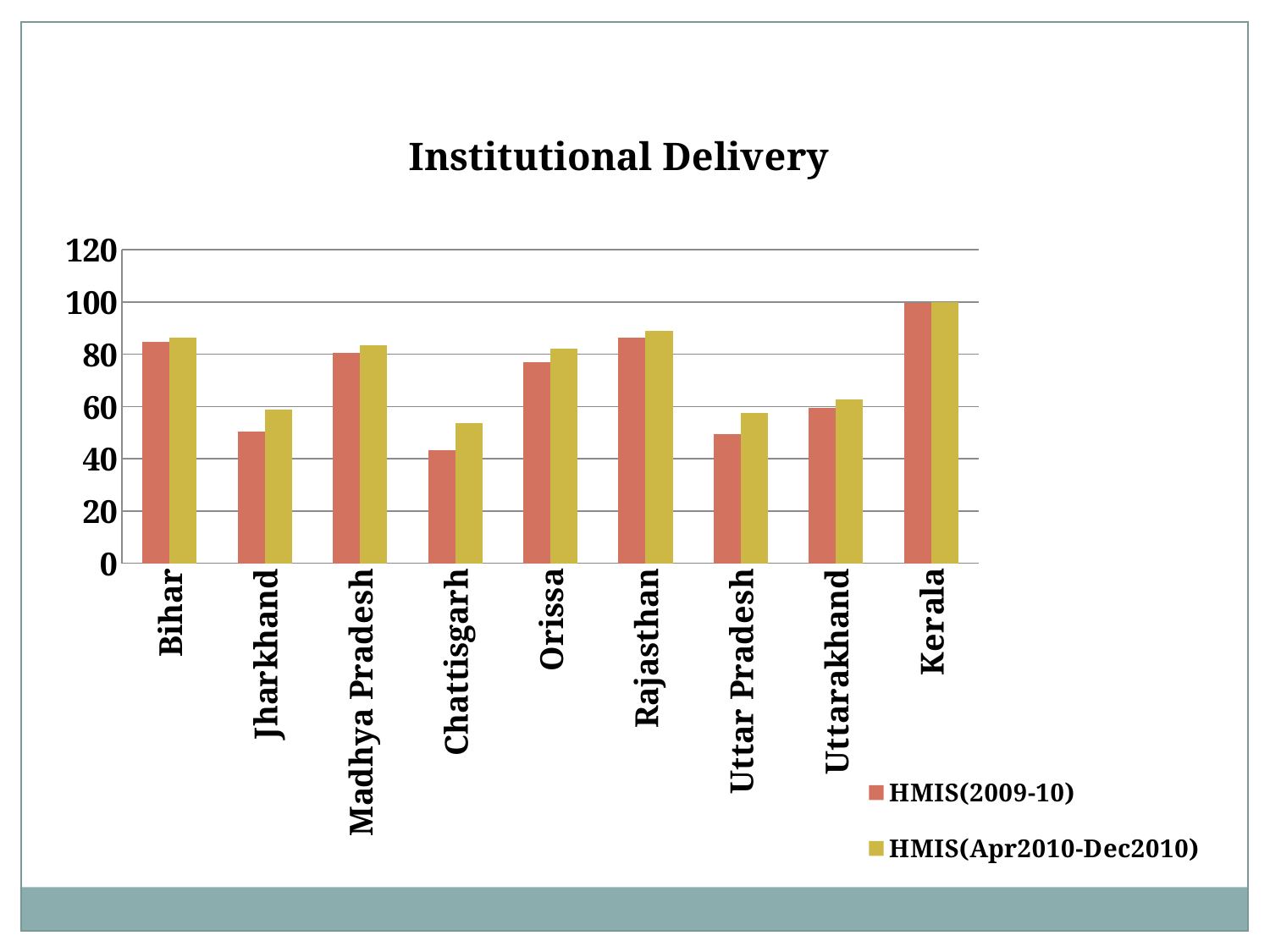
What is the title of the chart? Institutional Delivery How many series does the legend list? 2 Is the HMIS(Apr2010-Dec2010) value for Uttar Pradesh greater or less than 40? greater How many states are shown on the x axis? 9 Which state has the lowest value for HMIS(2009-10)? Chattisgarh Is the HMIS(2009-10) value for Bihar greater or less than 80? greater Which state has the highest value for HMIS(2009-10)? Kerala For Jharkhand, which series has the larger value, HMIS(2009-10) or HMIS(Apr2010-Dec2010)? HMIS(Apr2010-Dec2010) Which state has the lowest value for HMIS(Apr2010-Dec2010)? Chattisgarh Which series is shown in yellow in the legend? HMIS(Apr2010-Dec2010) What type of chart is shown on the slide? bar chart Is the HMIS(2009-10) value for Chattisgarh greater or less than 60? less